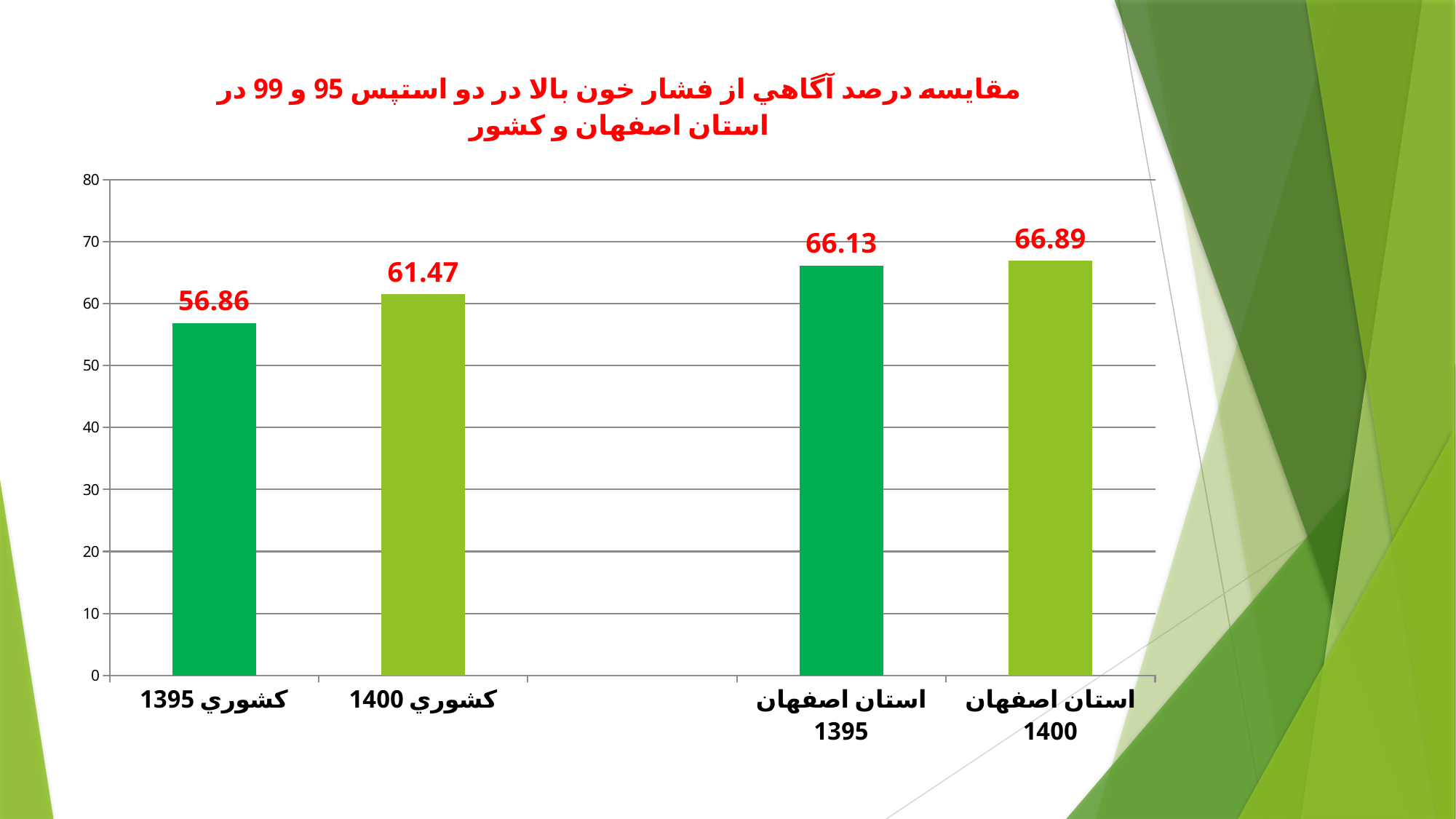
Which category has the highest value? استان اصفهان 1400 What is the value for کشوري 1395? 56.86 Is the value for کشوري 1395 greater or less than 60? less Which is larger, the value for کشوري 1400 or the value for استان اصفهان 1395? استان اصفهان 1395 What is the difference between the values for کشوري 1400 and کشوري 1395? 4.61 Which category has the lowest value? کشوري 1395 What is the value for استان اصفهان 1400? 66.89 What is the value for استان اصفهان 1395? 66.13 How many bars are shown in the chart? 4 What kind of chart is shown on the slide? bar chart What is the value for کشوري 1400? 61.47 What is the difference between the values for استان اصفهان 1400 and استان اصفهان 1395? 0.76